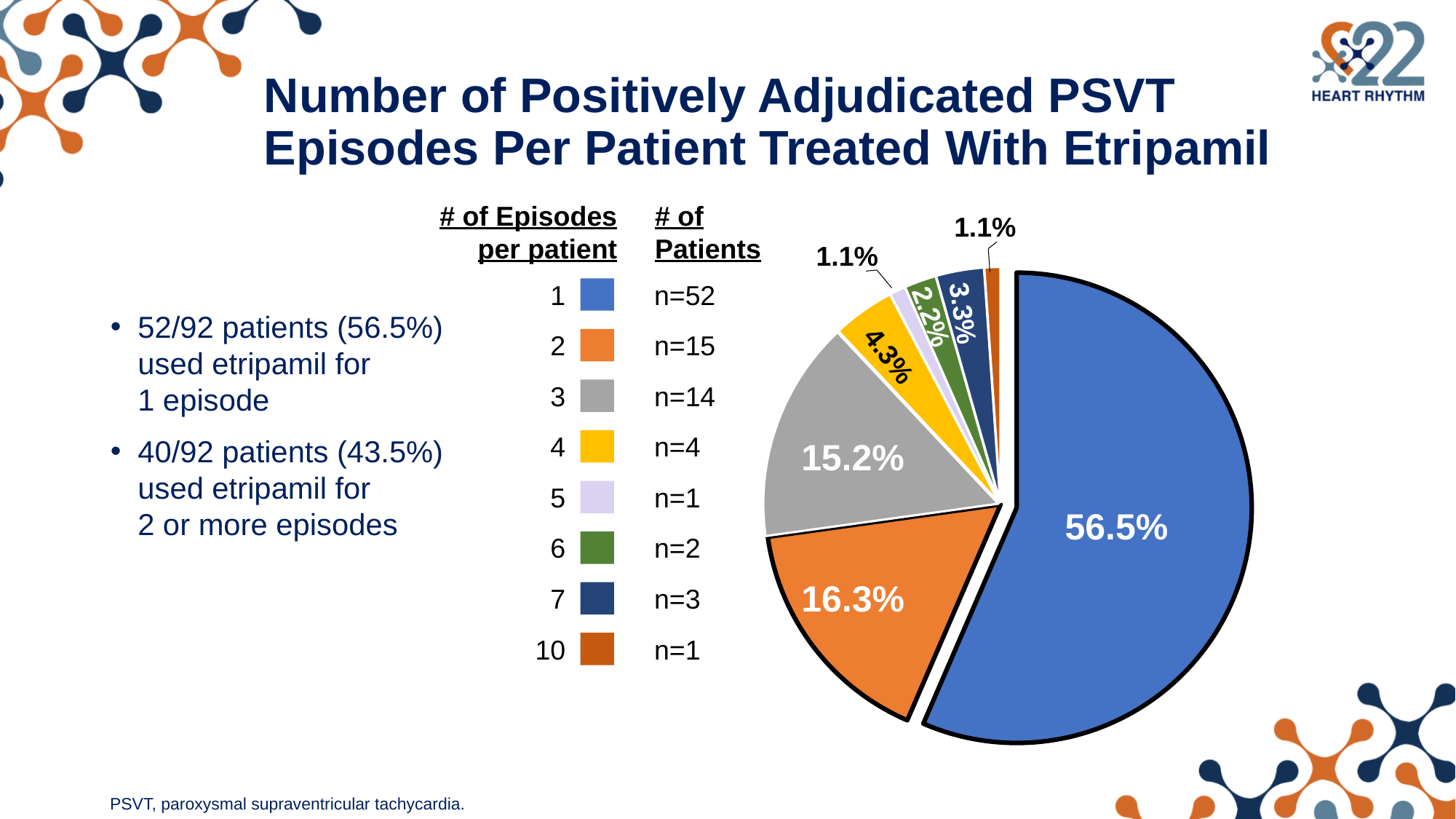
Which number of episodes per patient has the largest slice of the pie? 1 What kind of chart is shown on the slide? pie chart What share of the pie corresponds to patients with 7 episodes? 3.3% What is the difference in percentage points between the slice for 2 episodes and the slice for 3 episodes? 1.1% How many slices does the pie chart have? 8 Which slice is larger: the one for 6 episodes or the one for 7 episodes? 7 episodes What share of the pie corresponds to patients with 4 episodes? 4.3% How many patients had 3 episodes according to the legend? n=14 How many patients had 10 episodes according to the legend? n=1 What share of the pie corresponds to patients with 1 episode? 56.5%